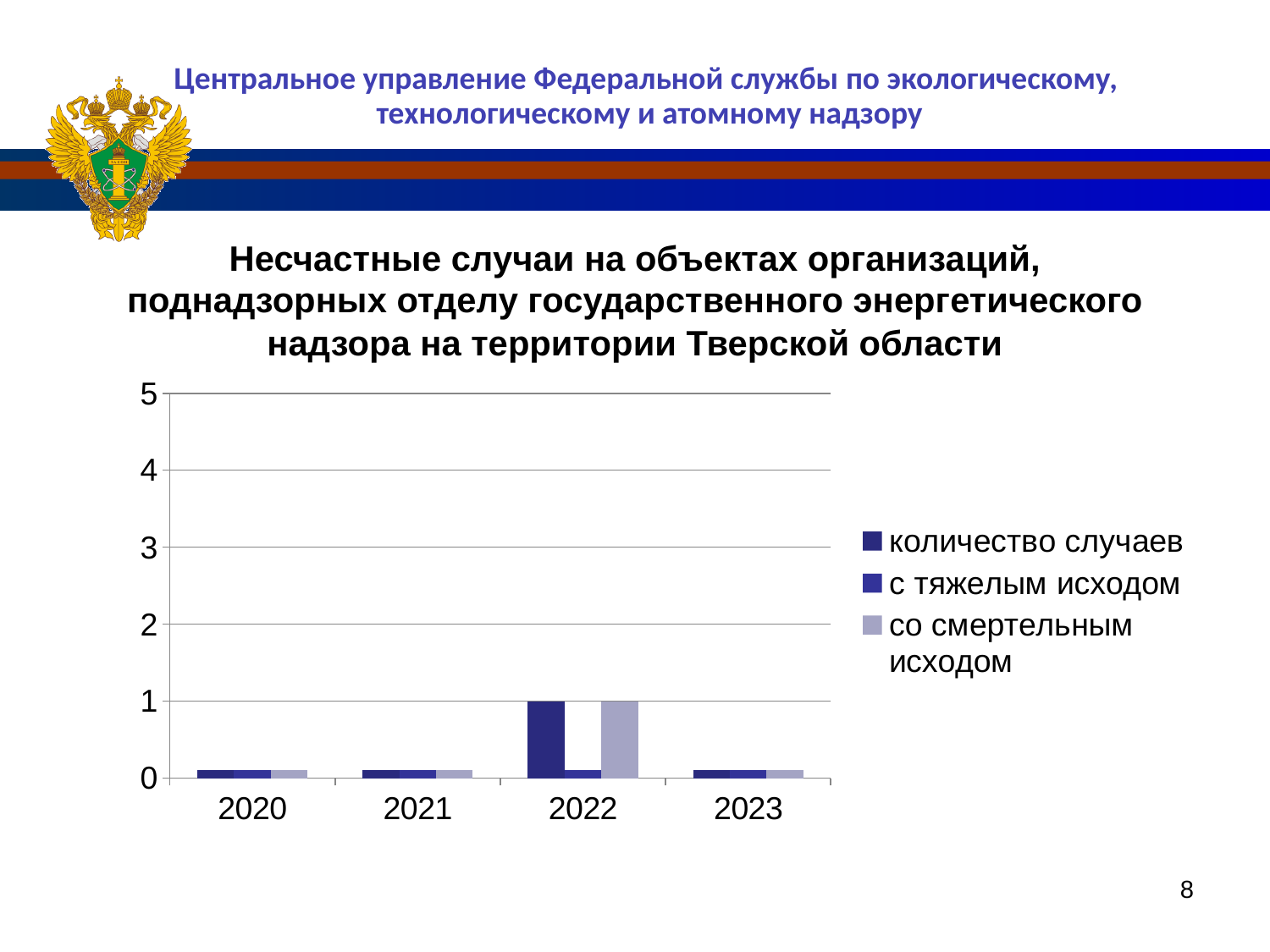
What is the value for 'со смертельным исходом' in 2022? 1 How many years are shown on the x axis of the chart? 4 In which year is 'количество случаев' highest? 2022 How many series does the chart legend list? 3 Which year has the larger value for 'количество случаев', 2021 or 2022? 2022 What kind of chart is shown on the slide? bar chart In which year is 'со смертельным исходом' highest? 2022 Is the value for 'количество случаев' in 2022 greater or less than 3? less What is the highest value shown on the chart's vertical axis? 5 Which series is listed second in the chart legend? с тяжелым исходом Is the value for 'со смертельным исходом' in 2022 greater or less than 2? less What is the value for 'количество случаев' in 2022? 1